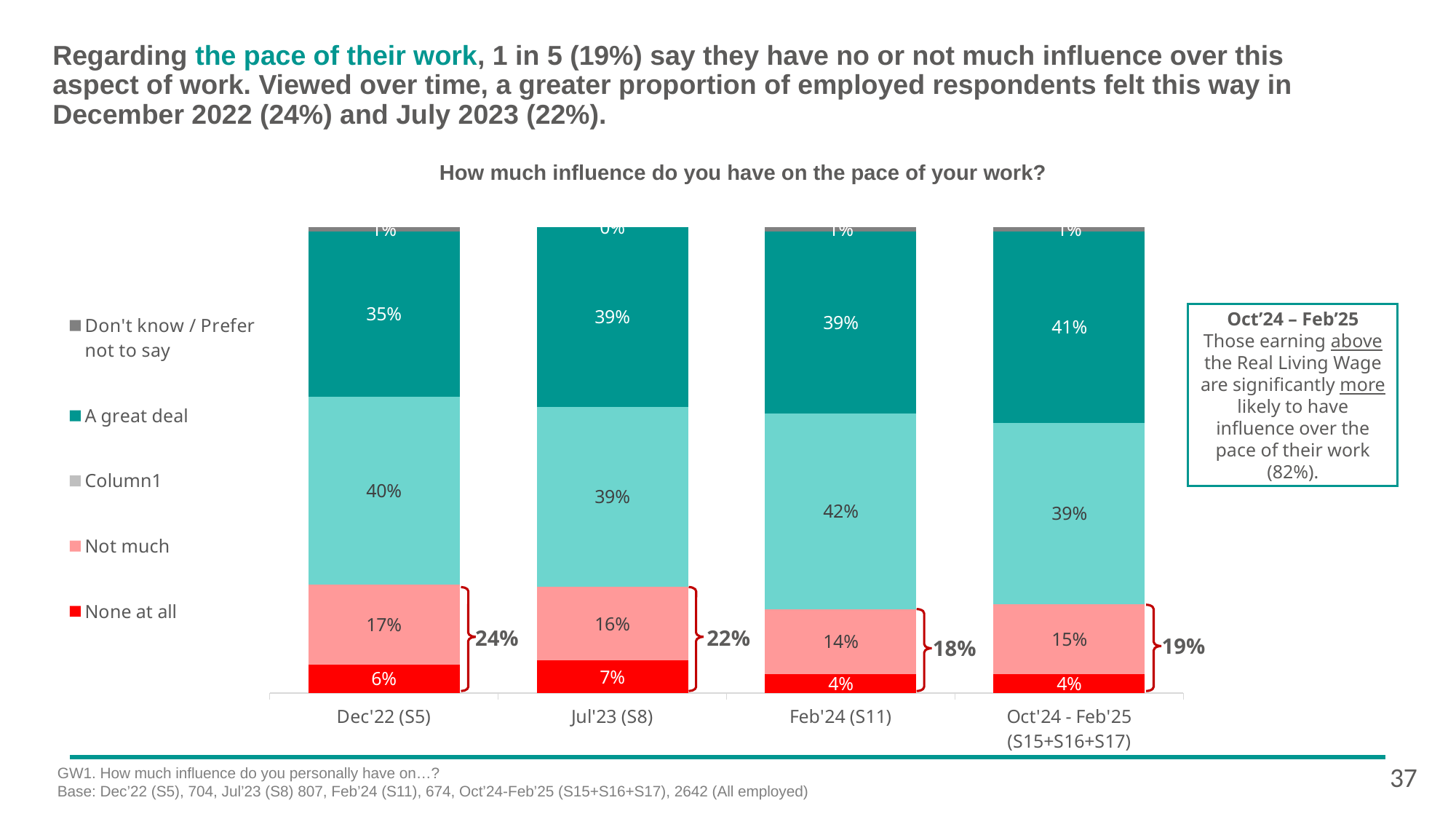
Which period has the lowest 'Not much' value? Feb'24 (S11) What is the difference between the 'Not much' values for Dec'22 (S5) and Feb'24 (S11)? 3 percentage points What percentage of respondents said they have 'A great deal' of influence in the Oct'24 - Feb'25 (S15+S16+S17) period? 41% Which is larger: the 'None at all' value for Dec'22 (S5) or for Jul'23 (S8)? Jul'23 (S8) Does the 'A great deal' value rise or fall from Dec'22 (S5) to Oct'24 - Feb'25 (S15+S16+S17)? Rise Which period has the highest 'A great deal' value? Oct'24 - Feb'25 (S15+S16+S17) How many time periods are shown on the x axis? 4 How many series does the legend list? 5 What is the 'Not much' value for Dec'22 (S5)? 17% What is the 'None at all' value for Jul'23 (S8)? 7% What kind of chart is shown on the slide? Stacked bar chart What is the combined 'None at all' and 'Not much' share for Dec'22 (S5), as shown by the bracket? 24%